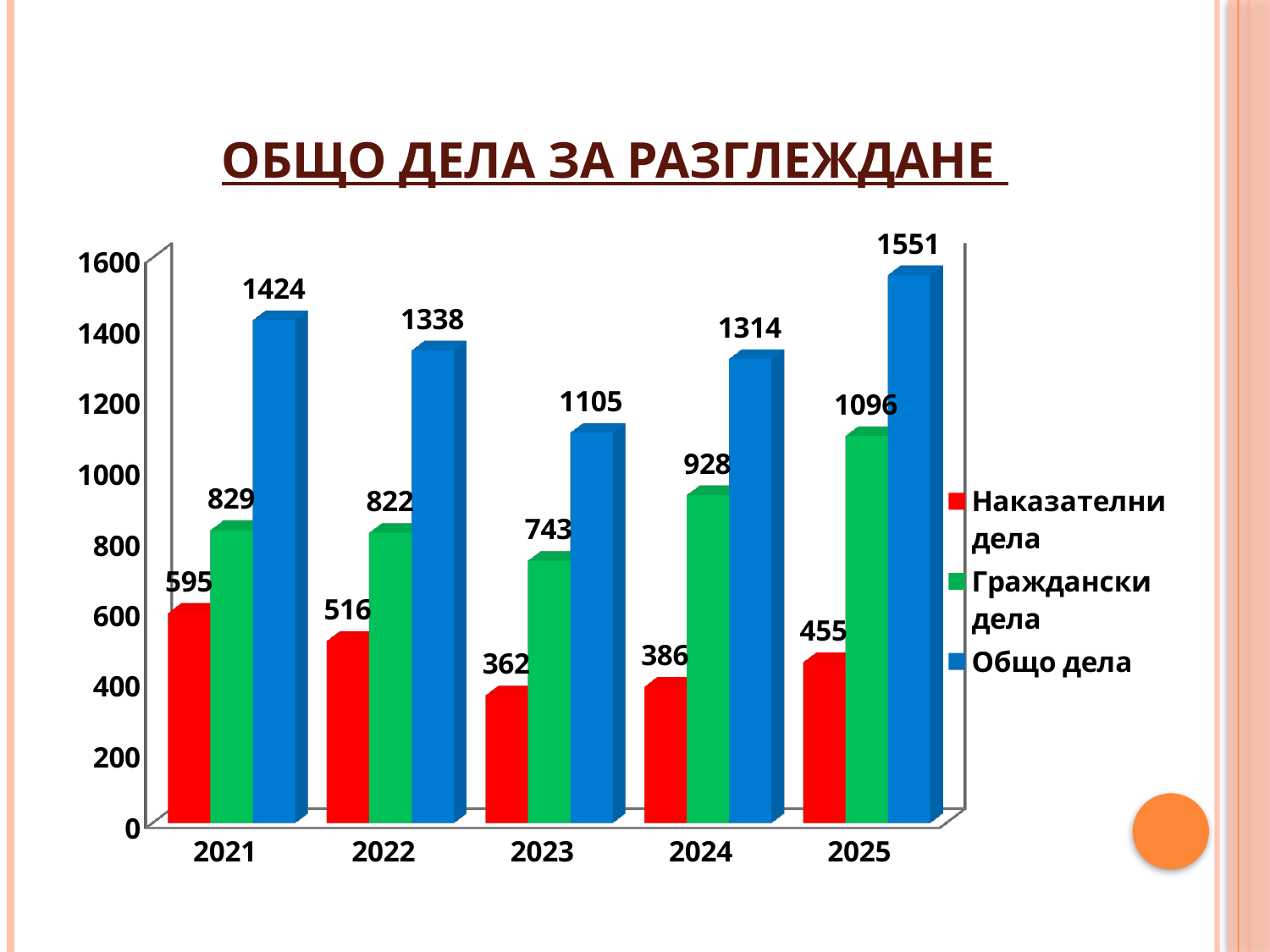
In which year is Наказателни дела lowest? 2023 What is the value for Наказателни дела in 2021? 595 What colour are the bars for Общо дела? Blue How many series does the legend list? 3 What kind of chart is shown on the slide? Bar chart What is the value for Общо дела in 2023? 1105 How many years are shown on the x axis? 5 What is the value for Граждански дела in 2024? 928 Does Наказателни дела rise or fall from 2021 to 2023? Fall In which year is Общо дела highest? 2025 Which is larger: Граждански дела in 2022 or Граждански дела in 2025? Граждански дела in 2025 What is the difference between Общо дела in 2025 and in 2021? 127